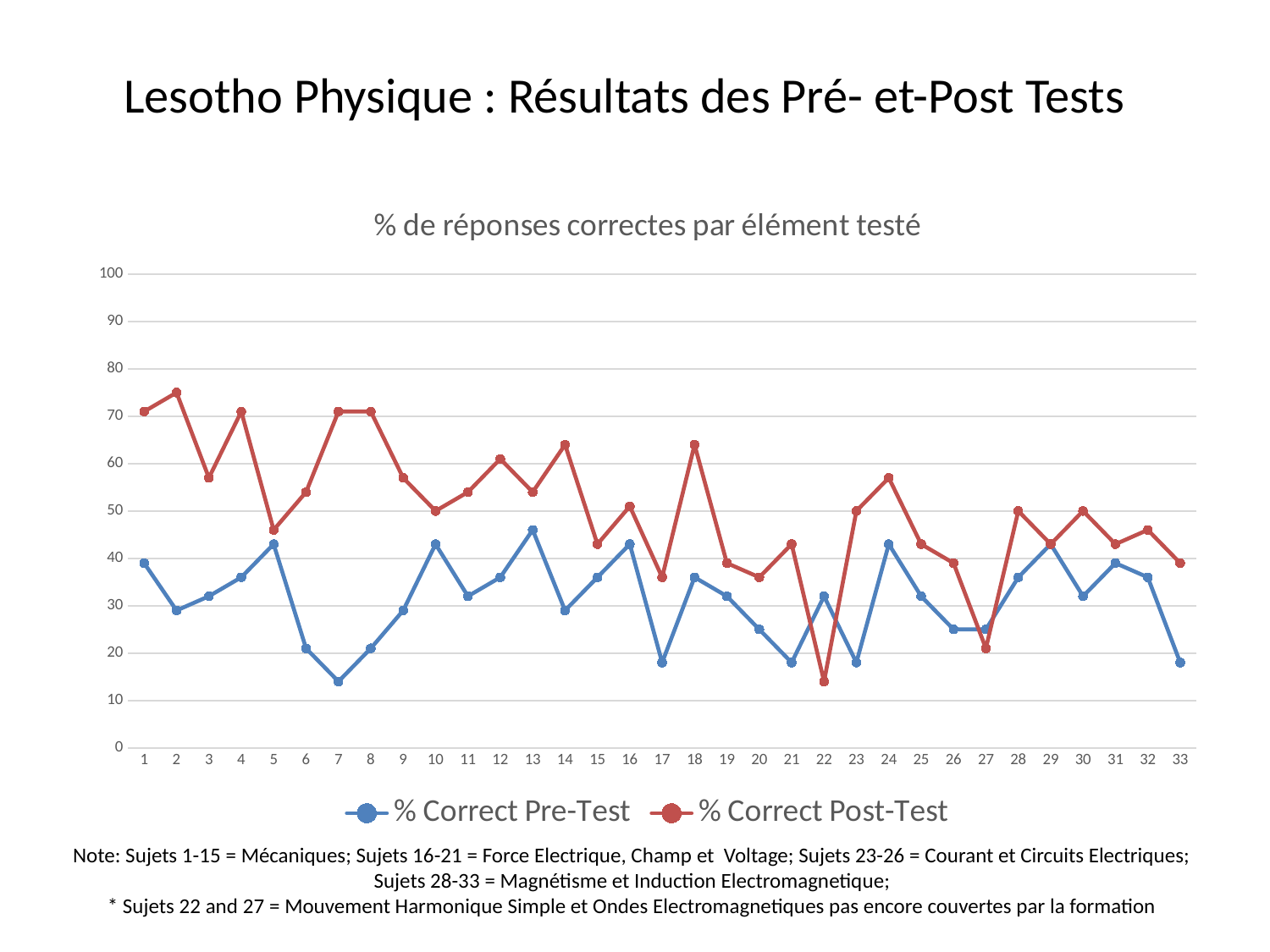
How many series does the legend list? 2 Is the % Correct Post-Test value for item 18 greater or less than 60? greater Is the % Correct Pre-Test value for item 6 greater or less than 30? less What is the title of the chart? % de réponses correctes par élément testé What kind of chart is shown on the slide? line chart For item 22, which is larger: % Correct Pre-Test or % Correct Post-Test? % Correct Pre-Test How many tested items (points) are shown along the x axis? 33 Which item has the lowest % Correct Post-Test value? 22 Which item has the highest % Correct Post-Test value? 2 Which item has the lowest % Correct Pre-Test value? 7 Does the % Correct Pre-Test line rise or fall from item 1 to item 7? fall Is the % Correct Post-Test value for item 2 greater or less than 70? greater